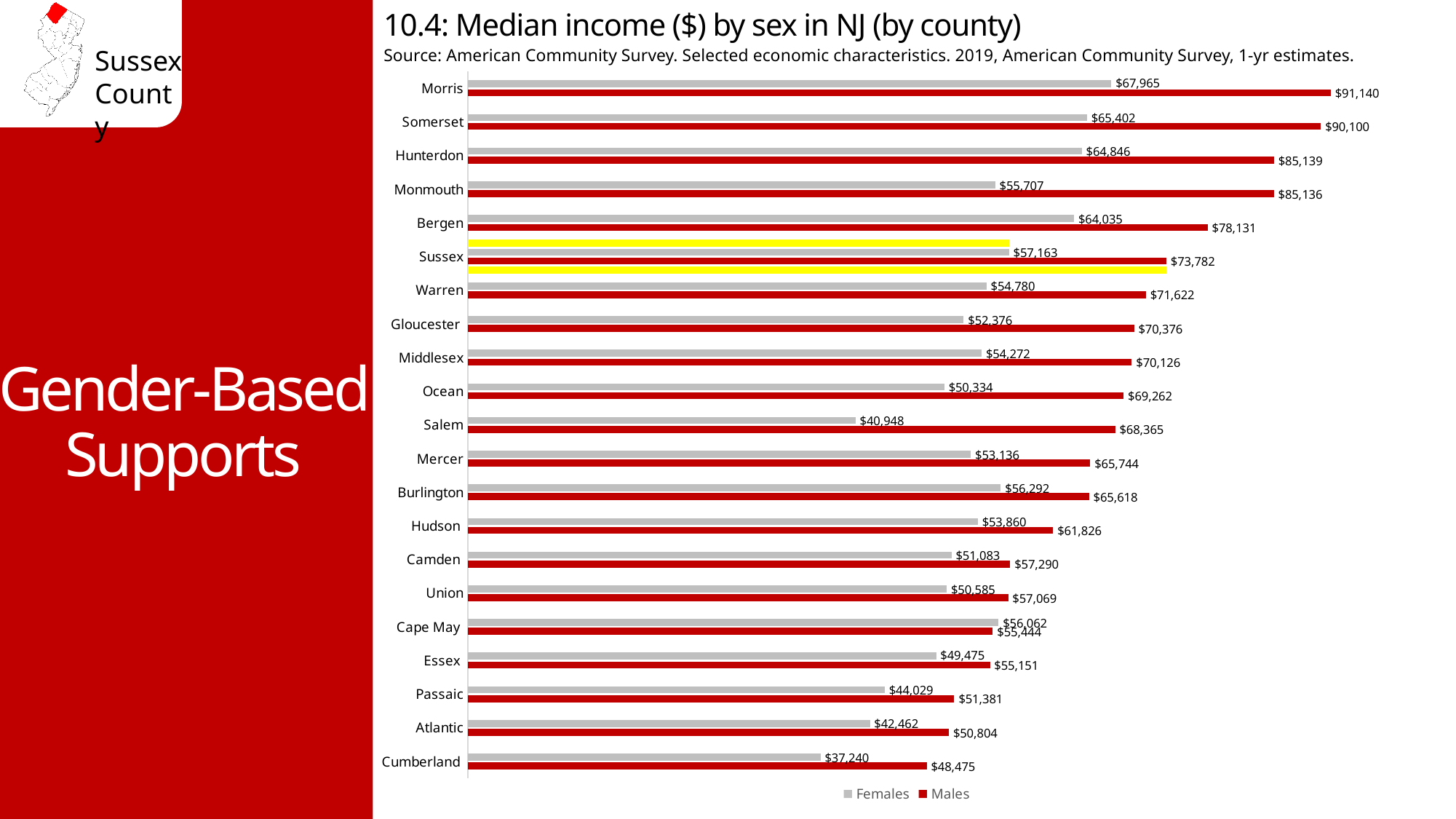
What is the median income for males in Sussex County? $73,782 How many series does the legend list? 2 Which colour represents the Males series in the chart? Red What is the median income for females in Cumberland County? $37,240 What is the difference between the male median incomes of Morris and Somerset counties? $1,040 Which county has the highest median income for males? Morris Which county has the lowest median income for females? Cumberland What is the difference between male and female median income in Sussex County? $16,619 How many counties are shown on the chart? 21 What is the median income for females in Morris County? $67,965 What kind of chart is shown on the slide? Bar chart Which is larger in Cape May County, the median income for females or for males? Females